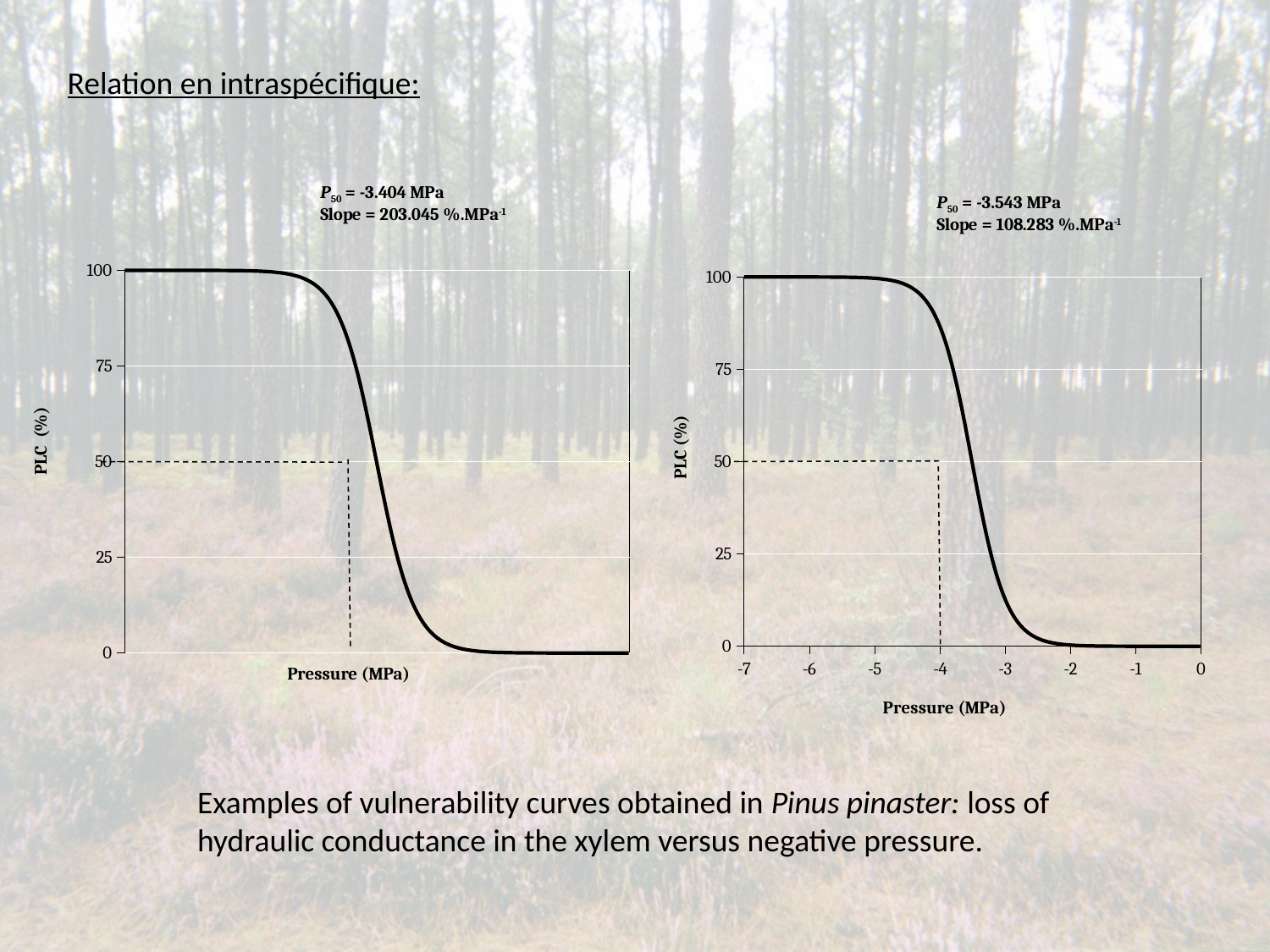
What kind of chart is the right chart on the slide? line chart In the right chart, is the PLC value at a pressure of -5 MPa greater or less than 75? greater What is the P50 value annotated above the left chart? -3.404 MPa In the left chart, do the PLC values rise or fall from left to right along the x axis? fall How many charts are shown on the slide? 2 In the right chart, is the PLC value at a pressure of -6 MPa greater or less than 50? greater In the right chart, is the PLC value at a pressure of -2 MPa greater or less than 25? less What is the y-axis label of the right chart? PLC (%) What is the slope value annotated above the right chart? 108.283 %.MPa-1 In the right chart, do the PLC values rise or fall as pressure goes from -7 to 0 along the x axis? fall What is the x-axis label of the left chart? Pressure (MPa) What kind of chart is the left chart on the slide? line chart